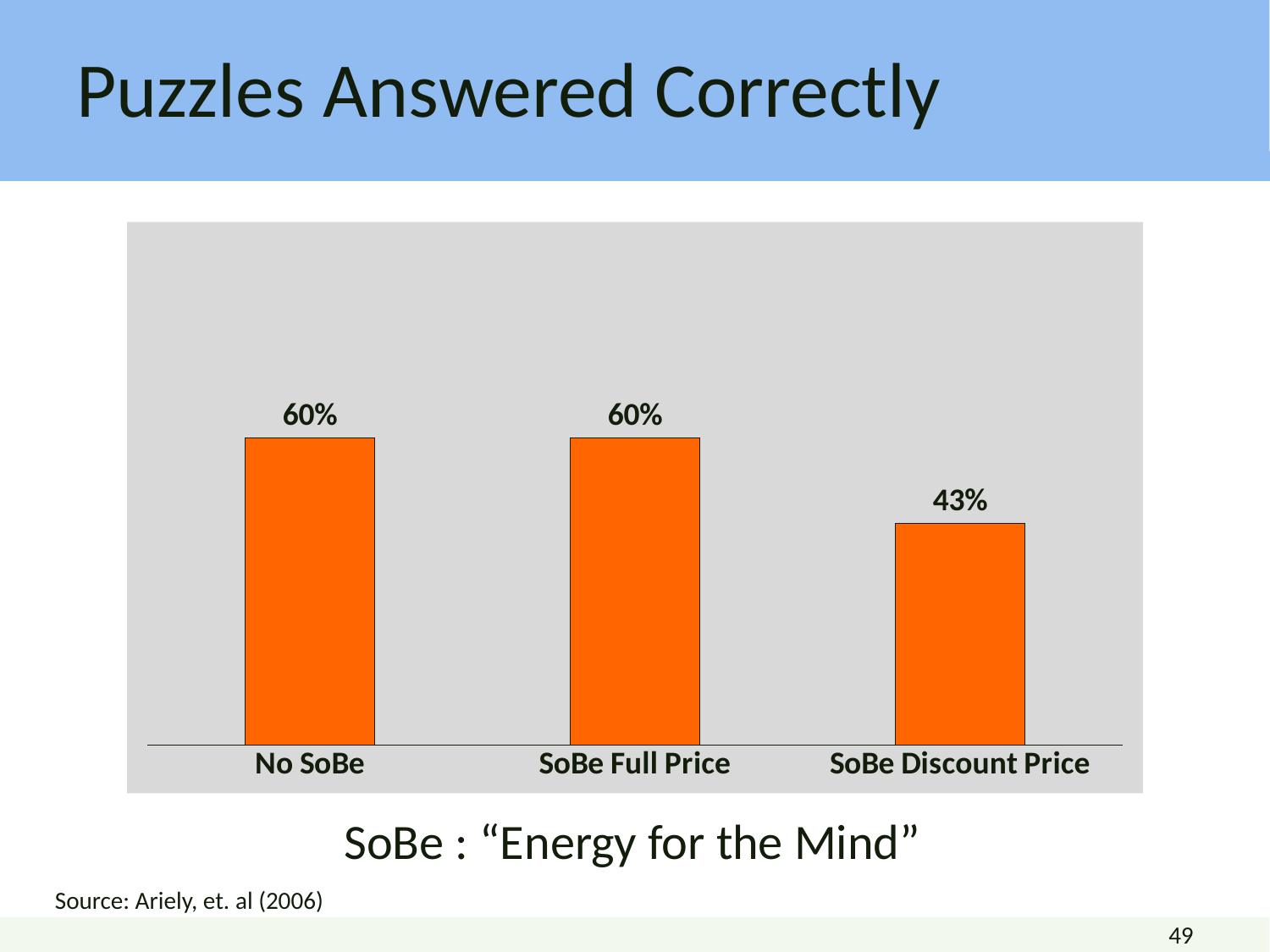
What kind of chart is shown on the slide? bar chart What is the title of the slide containing the chart? Puzzles Answered Correctly Which category has the lowest value? SoBe Discount Price What is the value for SoBe Discount Price? 43% What is the difference between the values for SoBe Full Price and SoBe Discount Price? 17% What is the value for No SoBe? 60% What is the value for SoBe Full Price? 60% Which is larger, the value for No SoBe or the value for SoBe Discount Price? No SoBe What colour are the bars in the chart? orange Do the values for No SoBe and SoBe Full Price differ? No, both are 60% How many categories are shown in the chart? 3